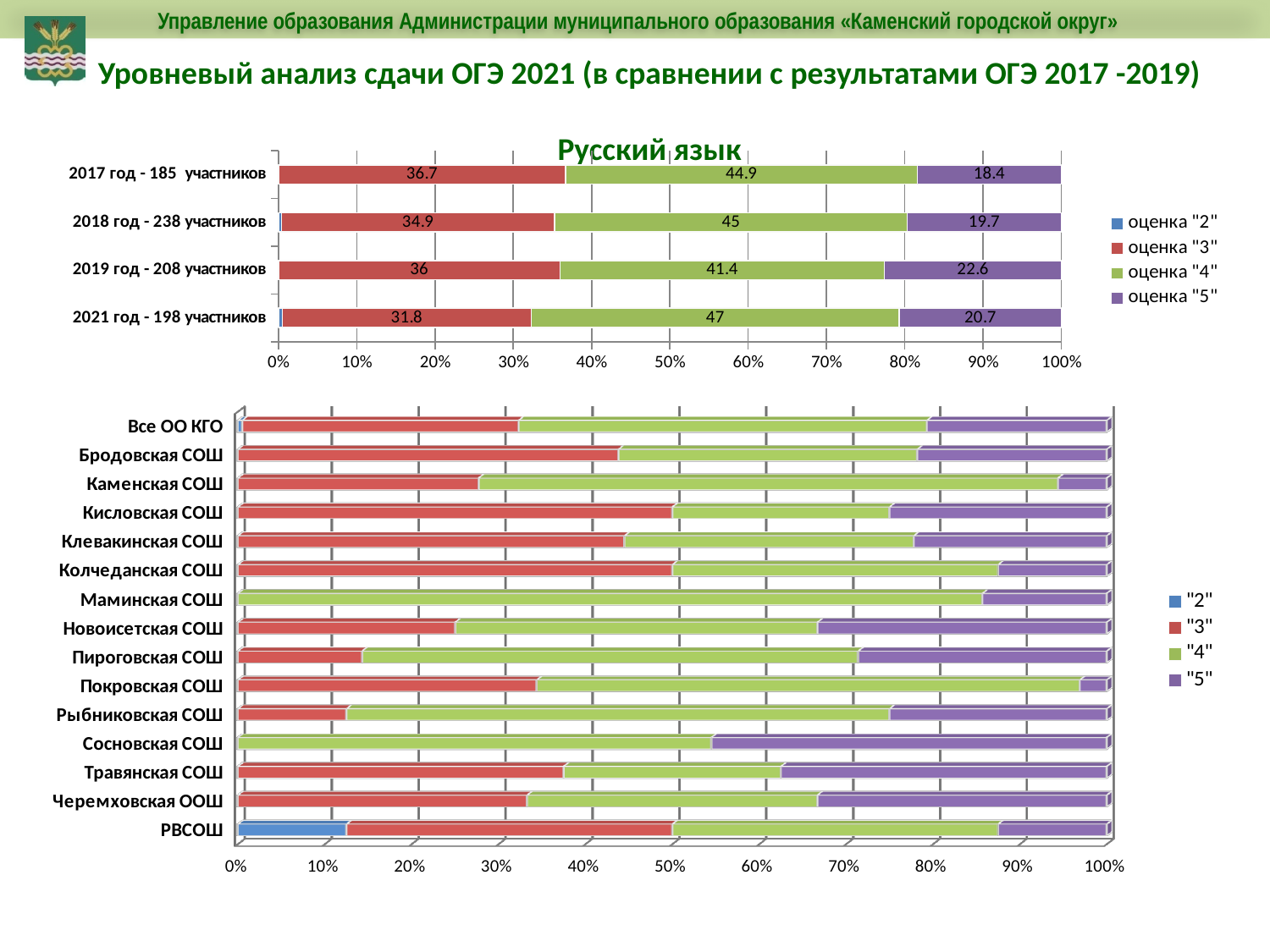
In the 'Русский язык' chart, what is the value for оценка "3" in 2017 год - 185 участников? 36.7 In the 'Русский язык' chart, which year has the lowest value for оценка "3"? 2021 год - 198 участников How many series does the legend of the 'Русский язык' chart list? 4 In the 'Русский язык' chart, what is the value for оценка "5" in 2019 год - 208 участников? 22.6 In the 'Русский язык' chart, which year has the highest value for оценка "5"? 2019 год - 208 участников In the 'Русский язык' chart, what is the difference between the оценка "4" values for 2021 год and 2019 год? 5.6 In the 'Русский язык' chart, what is the value for оценка "4" in 2021 год - 198 участников? 47 In the bottom chart, is the value for "2" at РВСОШ greater or less than 10%? greater In the bottom chart, is the value for "5" at Сосновская СОШ greater or less than 40%? greater In the 'Русский язык' chart, which is larger: оценка "3" in 2018 год or оценка "3" in 2019 год? 2019 год How many categories (rows) are shown in the bottom chart listing the schools? 15 What type of chart is the bottom chart listing the schools? Stacked bar chart